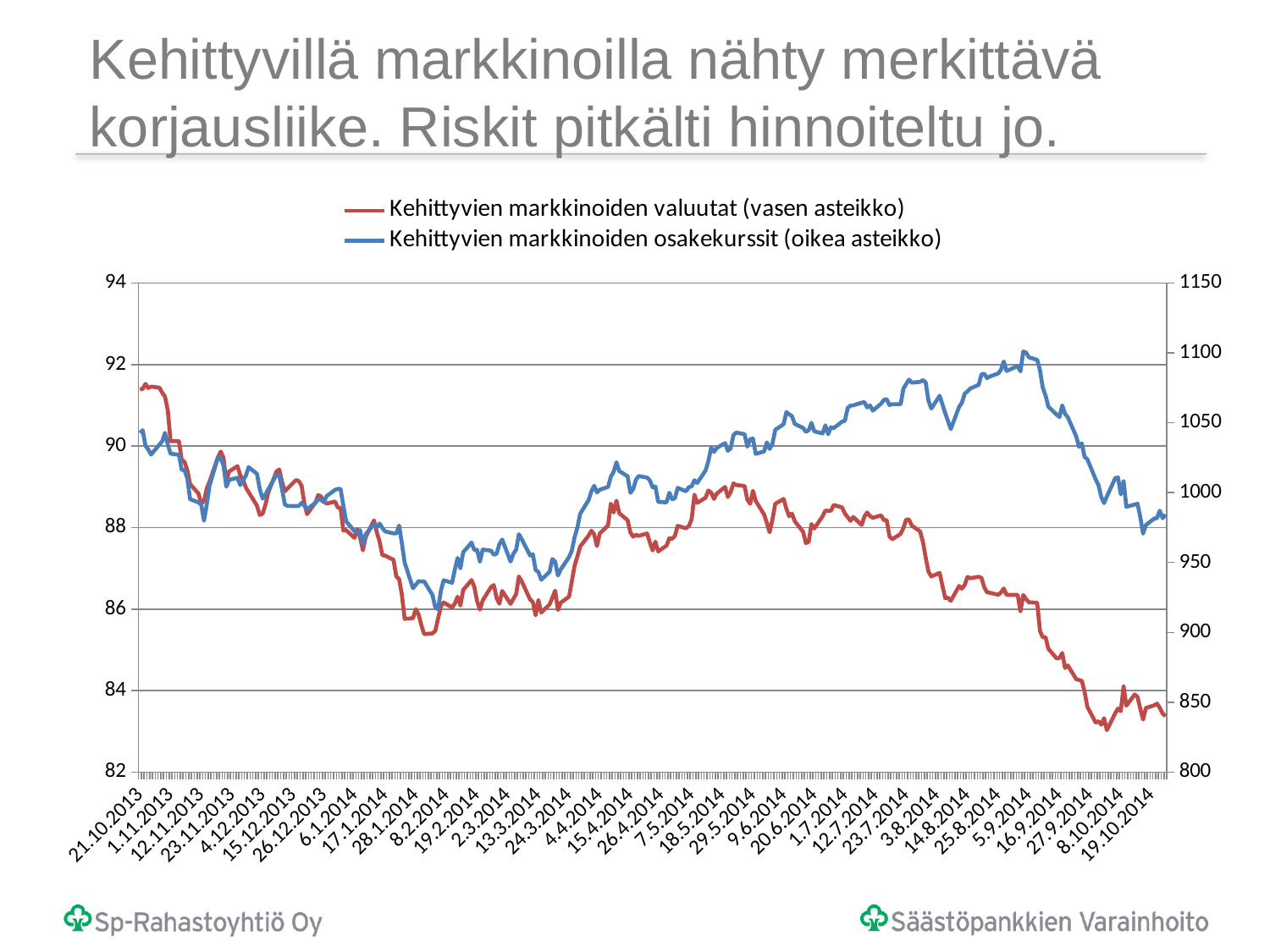
Which series is plotted against the left axis (vasen asteikko)? Kehittyvien markkinoiden valuutat Does the Kehittyvien markkinoiden valuutat line rise or fall between 3.8.2014 and 8.10.2014? fall Is the peak value of Kehittyvien markkinoiden osakekurssit around 5.9.2014 greater or less than 1050? greater Does the Kehittyvien markkinoiden osakekurssit line rise or fall between 8.2.2014 and 5.9.2014? rise Is the value of Kehittyvien markkinoiden valuutat at 21.10.2013 greater or less than 90? greater Is the value of Kehittyvien markkinoiden valuutat at 19.10.2014 greater or less than 86? less What kind of chart is shown on the slide? line chart How many series does the legend list? 2 What colour is the line for Kehittyvien markkinoiden osakekurssit? blue Does the Kehittyvien markkinoiden valuutat line overall rise or fall from 21.10.2013 to 19.10.2014? fall